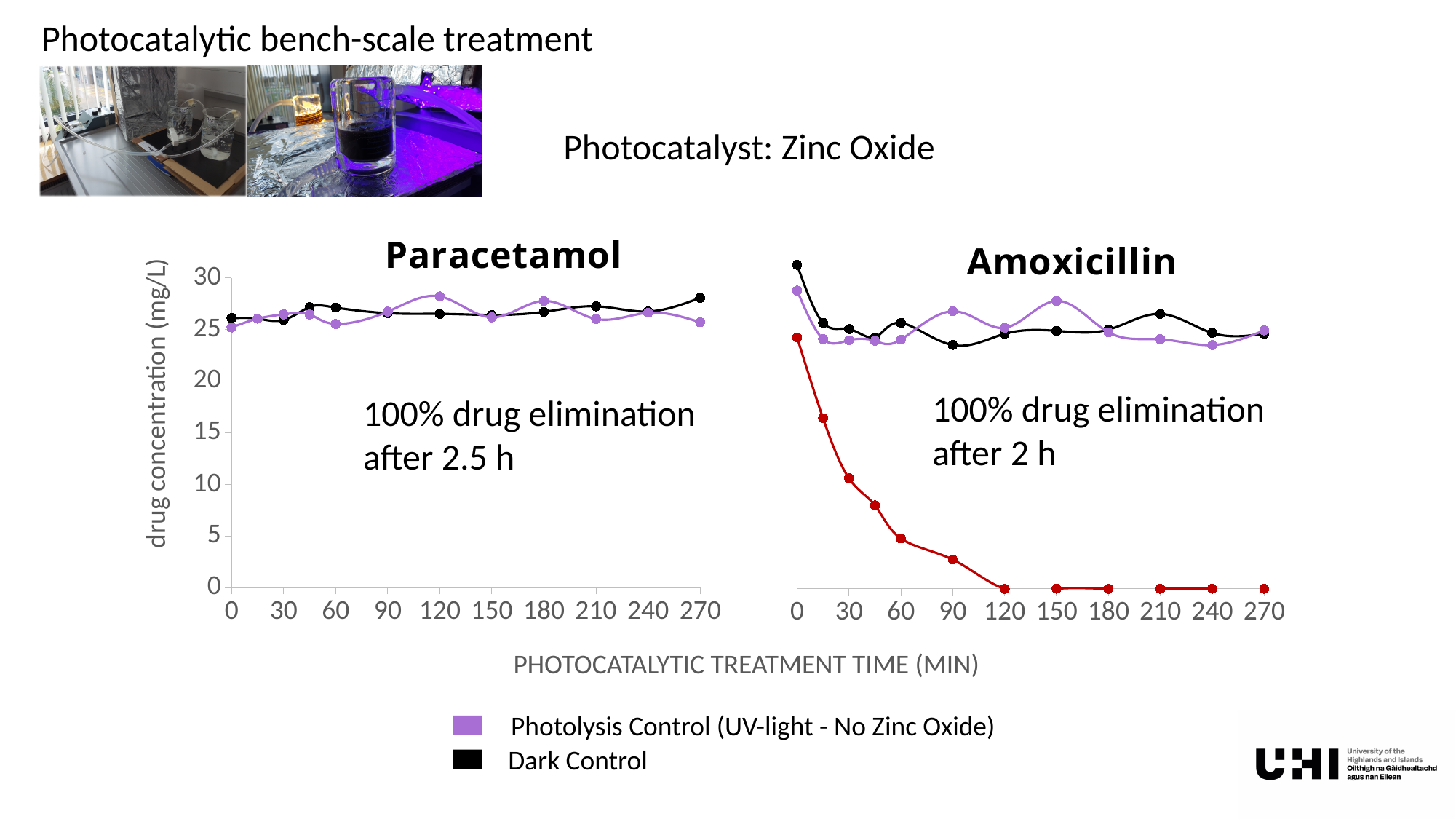
How many charts are shown on the slide? 2 In the Amoxicillin chart, is the value of the red series at 15 minutes greater or less than 15? greater What kind of chart is the Paracetamol chart? line chart In the Amoxicillin chart, is the Dark Control value at 0 minutes greater or less than 30? greater In the Amoxicillin chart, is the value of the red series at 120 minutes greater or less than 5? less In the Amoxicillin chart, which series has the lowest value at 270 minutes? the red series What is the label of the shared x axis of the two charts? PHOTOCATALYTIC TREATMENT TIME (MIN) In the Amoxicillin chart, does the red series rise or fall between 0 and 120 minutes? fall How many series does the legend at the bottom of the slide list? 2 In the Amoxicillin chart, which is larger at 0 minutes: the Dark Control value or the Photolysis Control value? Dark Control What is the label of the y axis on the Paracetamol chart? drug concentration (mg/L)